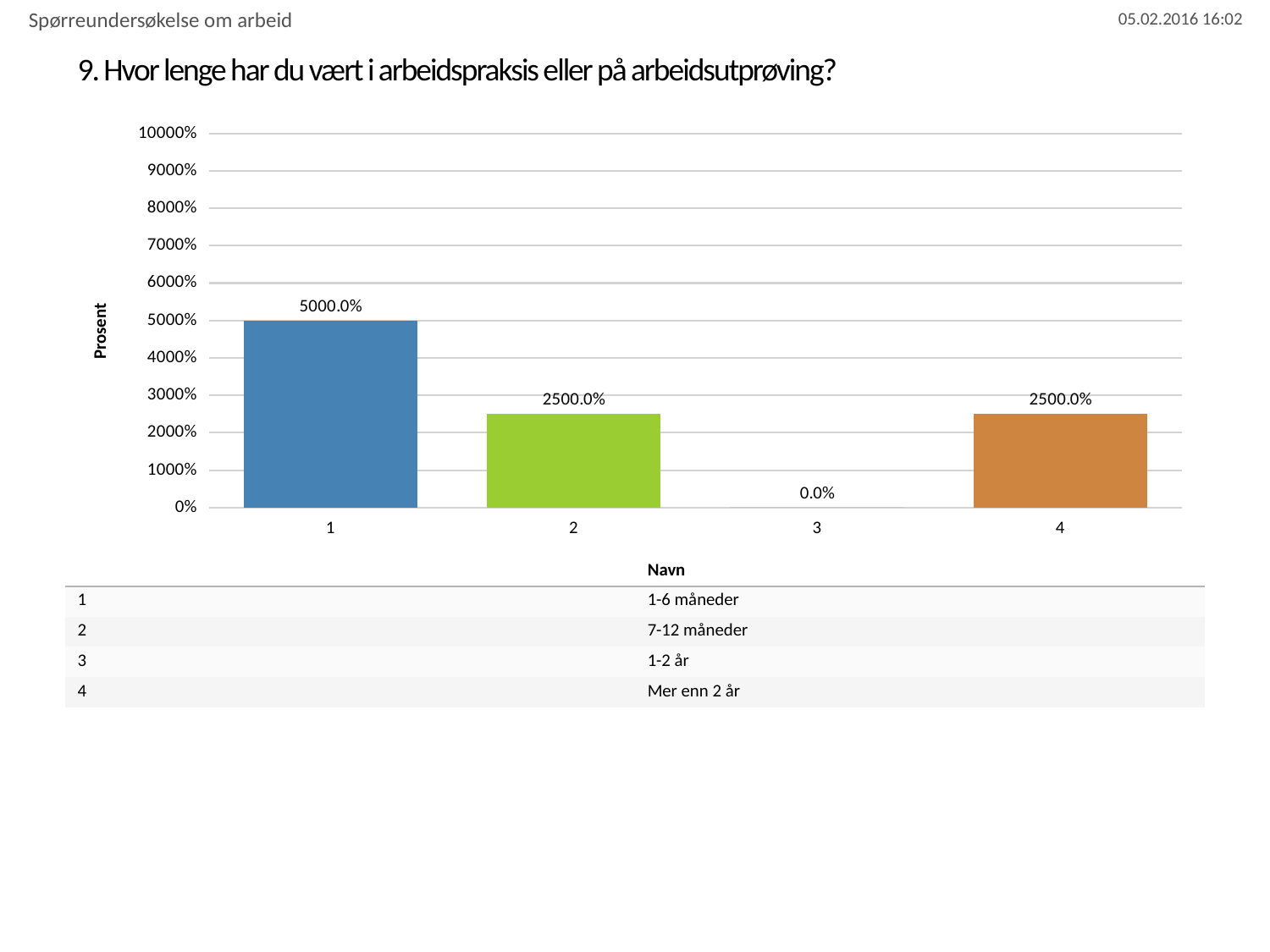
What kind of chart is shown on the slide? bar chart What is the value for category 4? 2500.0% What is the value for category 1? 5000.0% How many categories are shown on the x axis? 4 What is the value for category 3? 0.0% What is the value for category 2? 2500.0% What is the label of the y axis? Prosent Which category has the highest value? 1 Which is larger, the value for category 1 or the value for category 4? 1 What is the difference between the values for category 1 and category 2? 2500.0% Is the value for category 1 greater or less than 4000%? greater Which category has the lowest value? 3